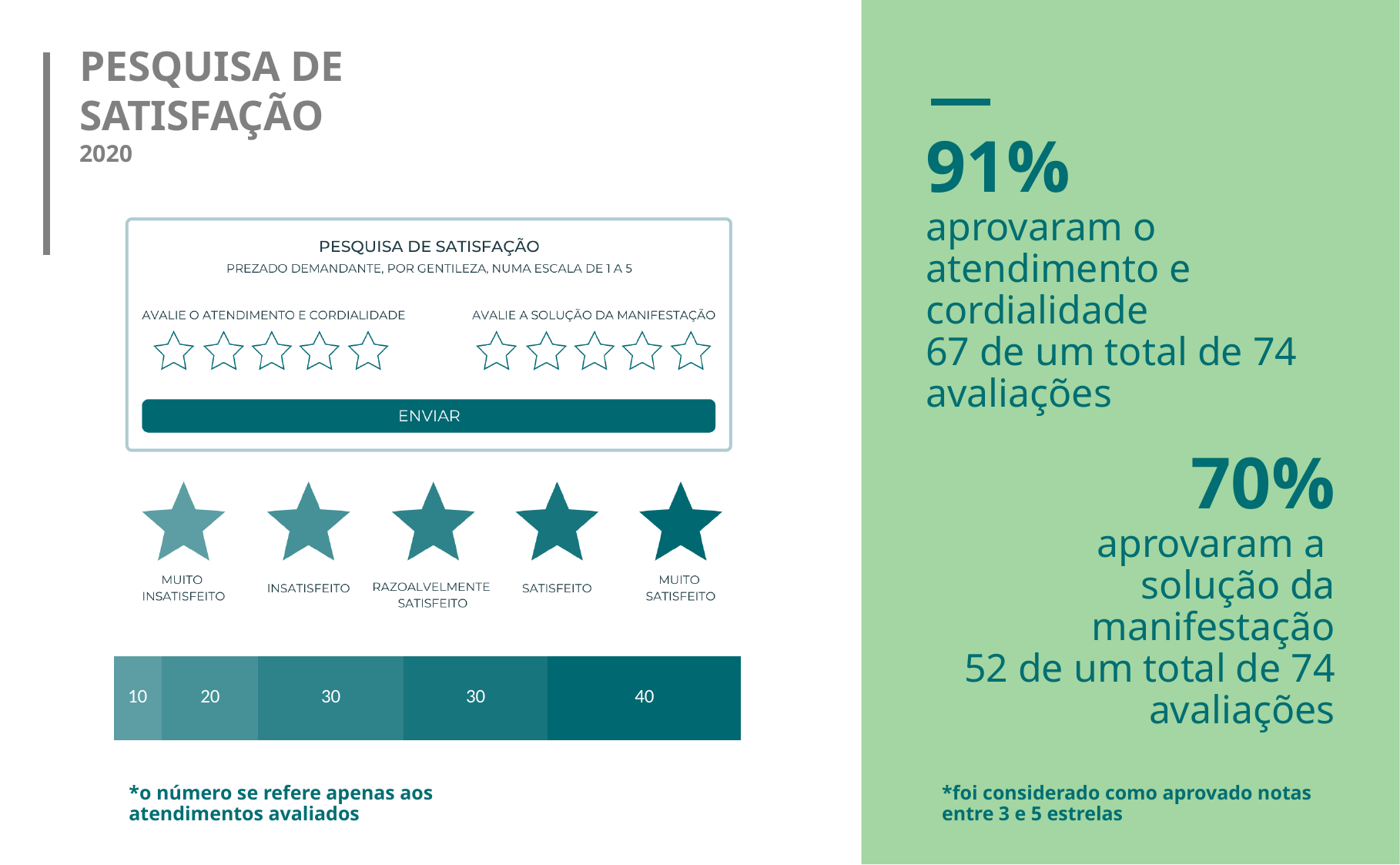
Which is larger, the second segment of the stacked bar or the third segment? the third segment (30) What is the total of all segments in the stacked bar? 130 What kind of chart is shown at the bottom of the slide? bar chart How many star rating categories are labelled above the stacked bar? 5 What is the value of the second segment of the stacked bar? 20 How many segments does the stacked bar at the bottom of the slide have? 5 What is the value of the first (leftmost) segment of the stacked bar? 10 What is the difference between the rightmost segment (40) and the leftmost segment (10) of the stacked bar? 30 Which segment of the stacked bar has the largest value? the rightmost segment (40) What is the value of the last (rightmost) segment of the stacked bar? 40 Which segment of the stacked bar has the smallest value? the leftmost segment (10) Do the segment values of the stacked bar rise or fall from left to right? rise